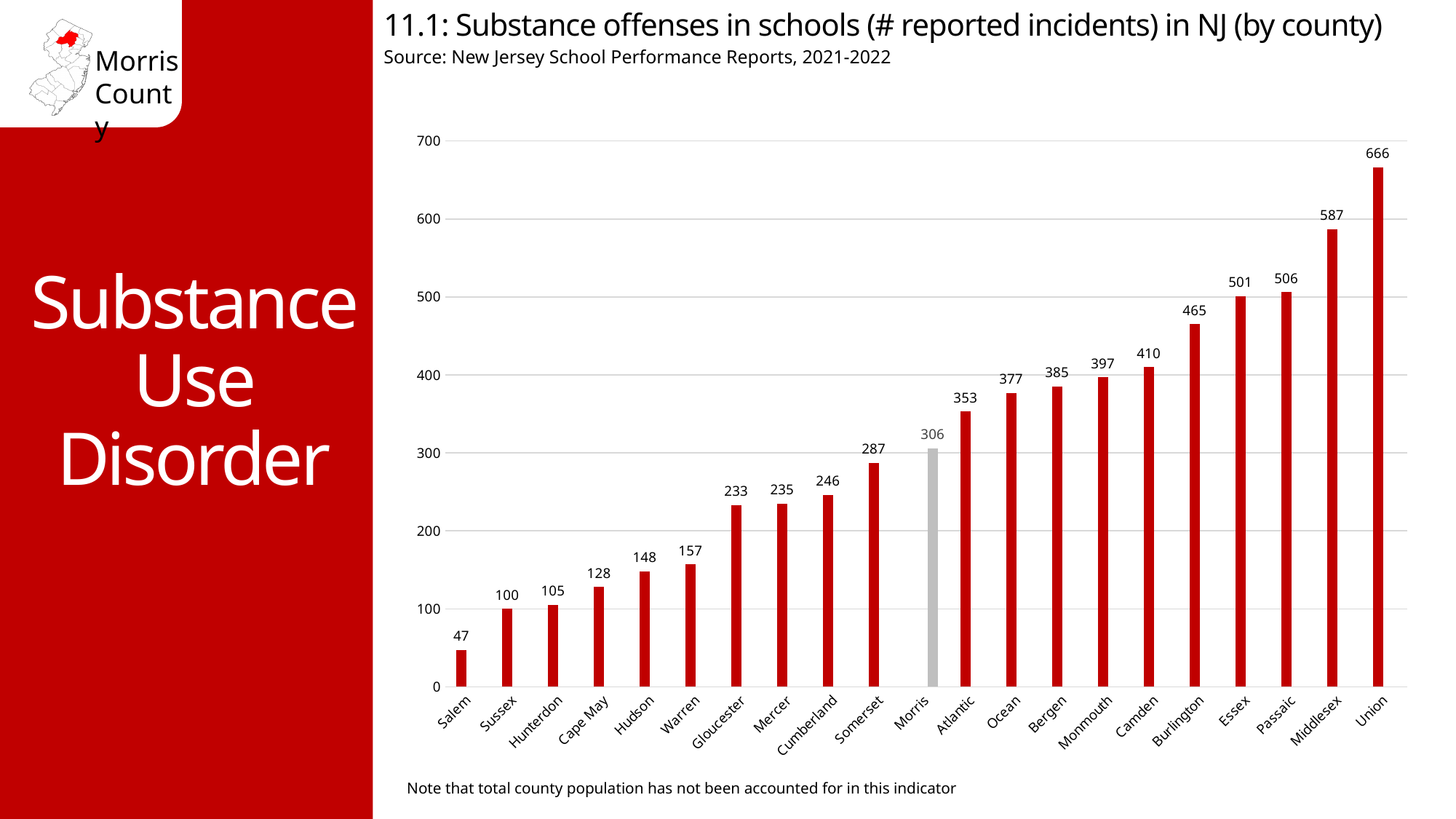
Which county has the lowest number of reported incidents? Salem What is the value shown for Essex county? 501 How many counties are shown on the chart? 21 What is the difference between the values for Union and Middlesex? 79 Which county has the highest number of reported incidents? Union Is the value for Burlington greater or less than 400? greater What is the value shown for Hudson county? 148 What kind of chart is shown on the slide? Bar chart What is the difference between the values for Morris and Somerset? 19 Which county's bar is shown in gray rather than red? Morris What is the number of reported substance offense incidents in schools for Morris county? 306 Which county has a larger value, Camden or Bergen? Camden